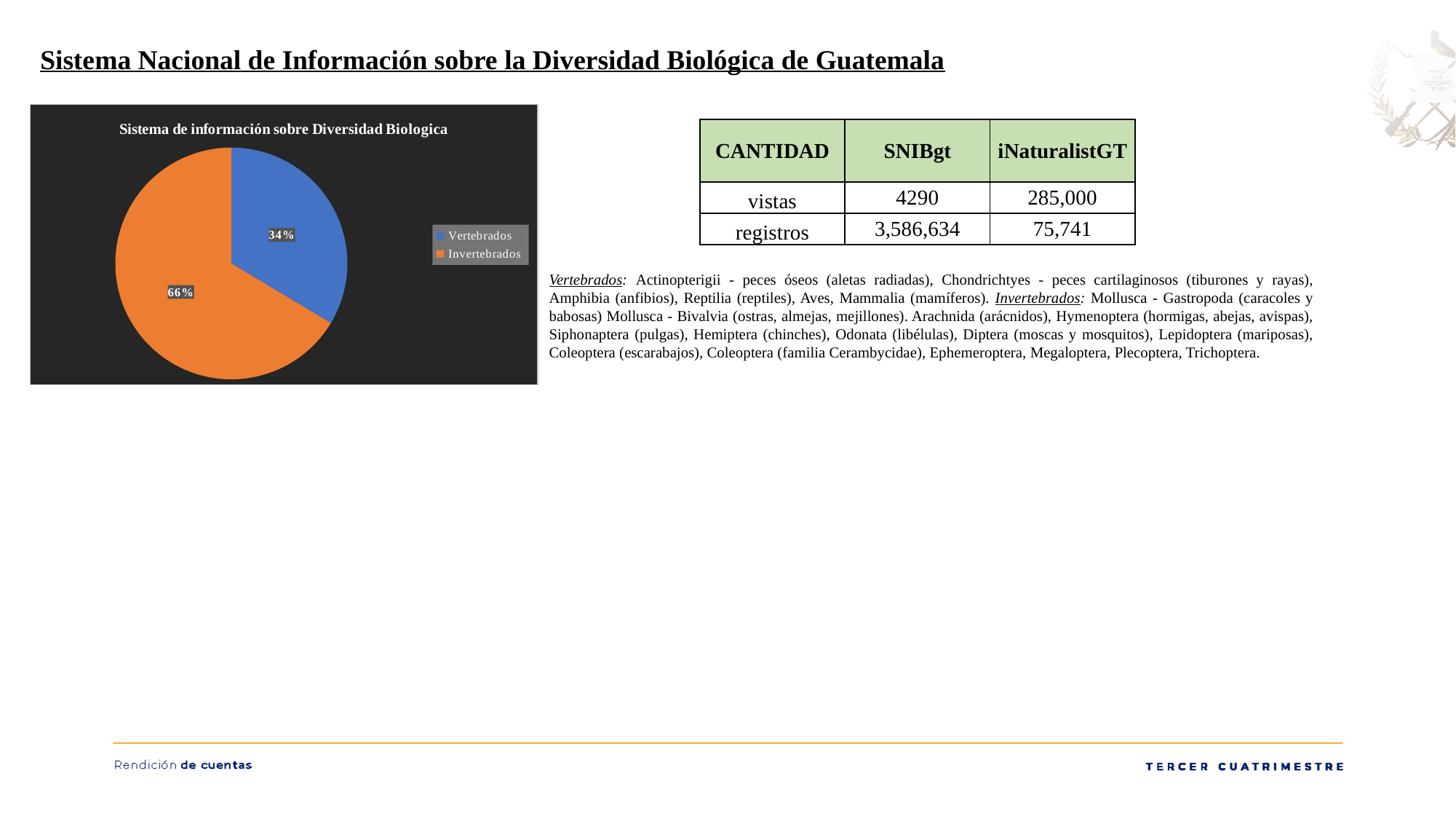
What kind of chart is shown on the slide? pie chart What share of the pie does Invertebrados represent? 66% What share of the pie does Vertebrados represent? 34% How many entries does the legend of the pie chart list? 2 Is the share for Vertebrados greater or less than 50%? less What colour is the Invertebrados slice in the pie chart? orange Which slice of the pie chart is the smallest? Vertebrados What is the difference in percentage points between the Invertebrados and Vertebrados slices? 32 How many slices does the pie chart have? 2 What is the title of the pie chart? Sistema de información sobre Diversidad Biologica Which is larger in the pie chart, Vertebrados or Invertebrados? Invertebrados Which slice of the pie chart is the largest? Invertebrados